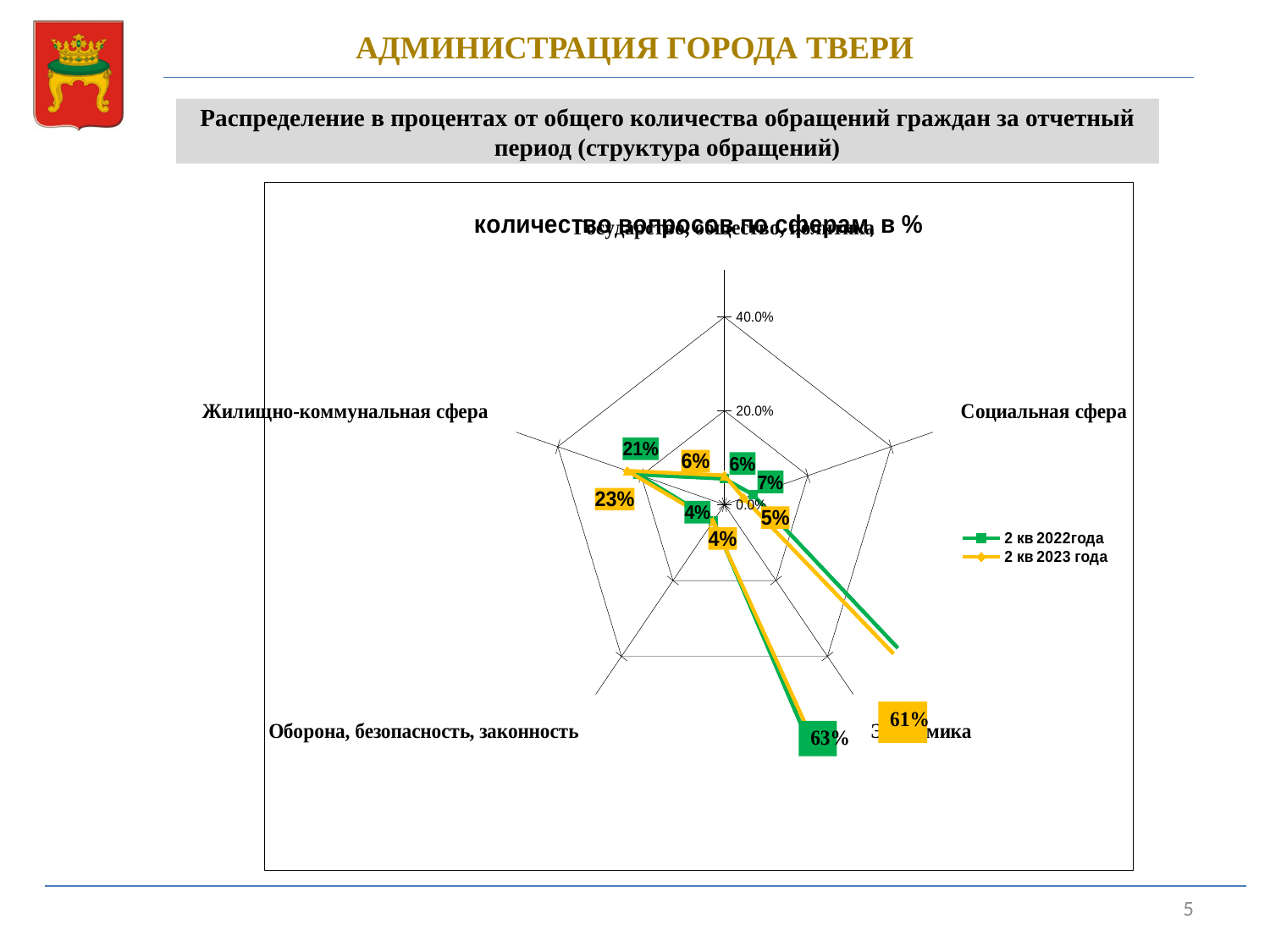
How many series does the legend list? 2 What is the value for Жилищно-коммунальная сфера in the 2 кв 2022года series? 21% Which category has the highest value in the 2 кв 2022года series? Экономика Which series has the larger value for Жилищно-коммунальная сфера, 2 кв 2022года or 2 кв 2023 года? 2 кв 2023 года What is the value for Жилищно-коммунальная сфера in the 2 кв 2023 года series? 23% What is the difference between the 2 кв 2022года and 2 кв 2023 года values for Экономика? 2% What kind of chart is shown on the slide? radar chart What is the value for Социальная сфера in the 2 кв 2022года series? 7% What is the value for Оборона, безопасность, законность in the 2 кв 2023 года series? 4% What is the value for Социальная сфера in the 2 кв 2023 года series? 5% What are the two series named in the legend? 2 кв 2022года and 2 кв 2023 года How many categories (axes) does the radar chart have? 5